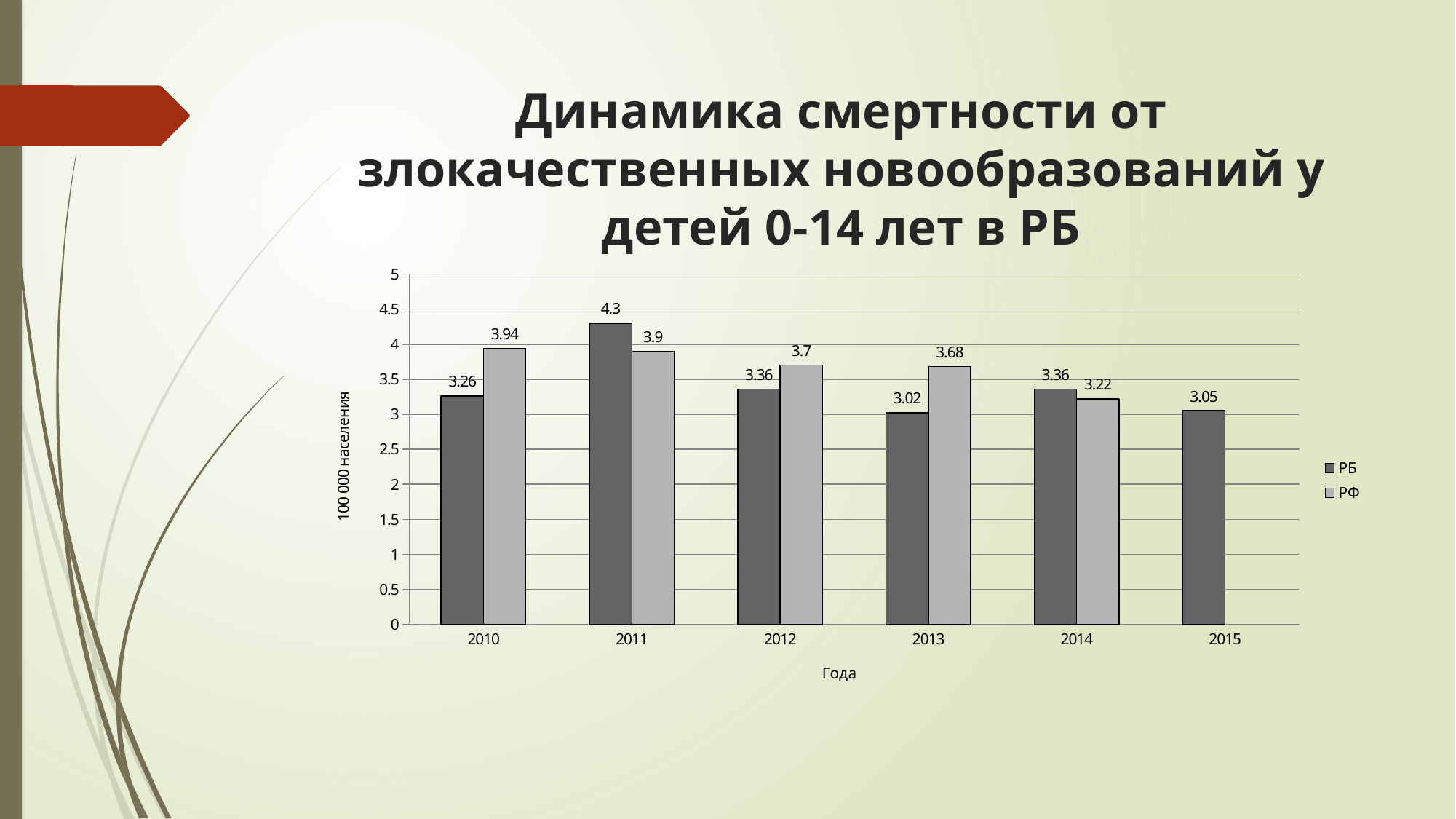
What is the value for РФ in 2010? 3.94 Do the РФ values rise or fall from 2010 to 2014? Fall Which is larger in 2014, the РБ value or the РФ value? РБ What is the value for РБ in 2015? 3.05 In which year is the РБ value highest? 2011 What is the difference between the РФ and РБ values in 2010? 0.68 How many series does the legend list? 2 How many years are shown on the x axis? 6 In which year is the РФ value lowest? 2014 What kind of chart is shown on the slide? Bar chart In which year is the РБ value lowest? 2013 What is the value for РБ in 2011? 4.3